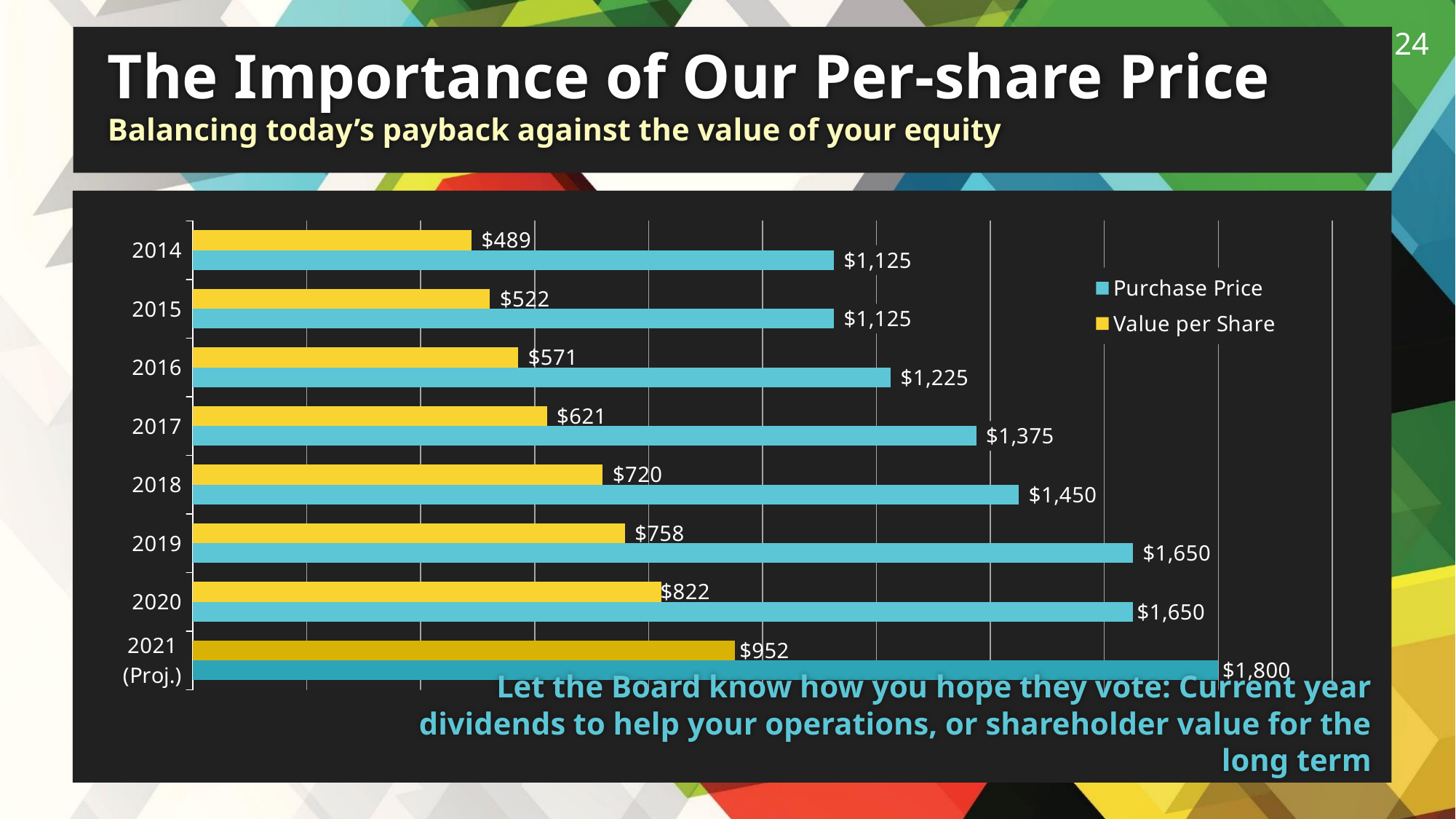
What is the Value per Share for 2019? $758 How many years are shown on the chart? 8 How many series does the legend list? 2 Which is larger, the Value per Share in 2016 or in 2017? 2017 What is the difference between the Purchase Price and the Value per Share in 2018? $730 What is the Value per Share for 2014? $489 What kind of chart is shown on the slide? Bar chart What is the Purchase Price for 2017? $1,375 Which year has the highest Purchase Price? 2021 (Proj.) What is the difference in Value per Share between 2021 (Proj.) and 2020? $130 Which year has the lowest Value per Share? 2014 Does the Value per Share rise or fall from 2014 to 2021 (Proj.)? Rise